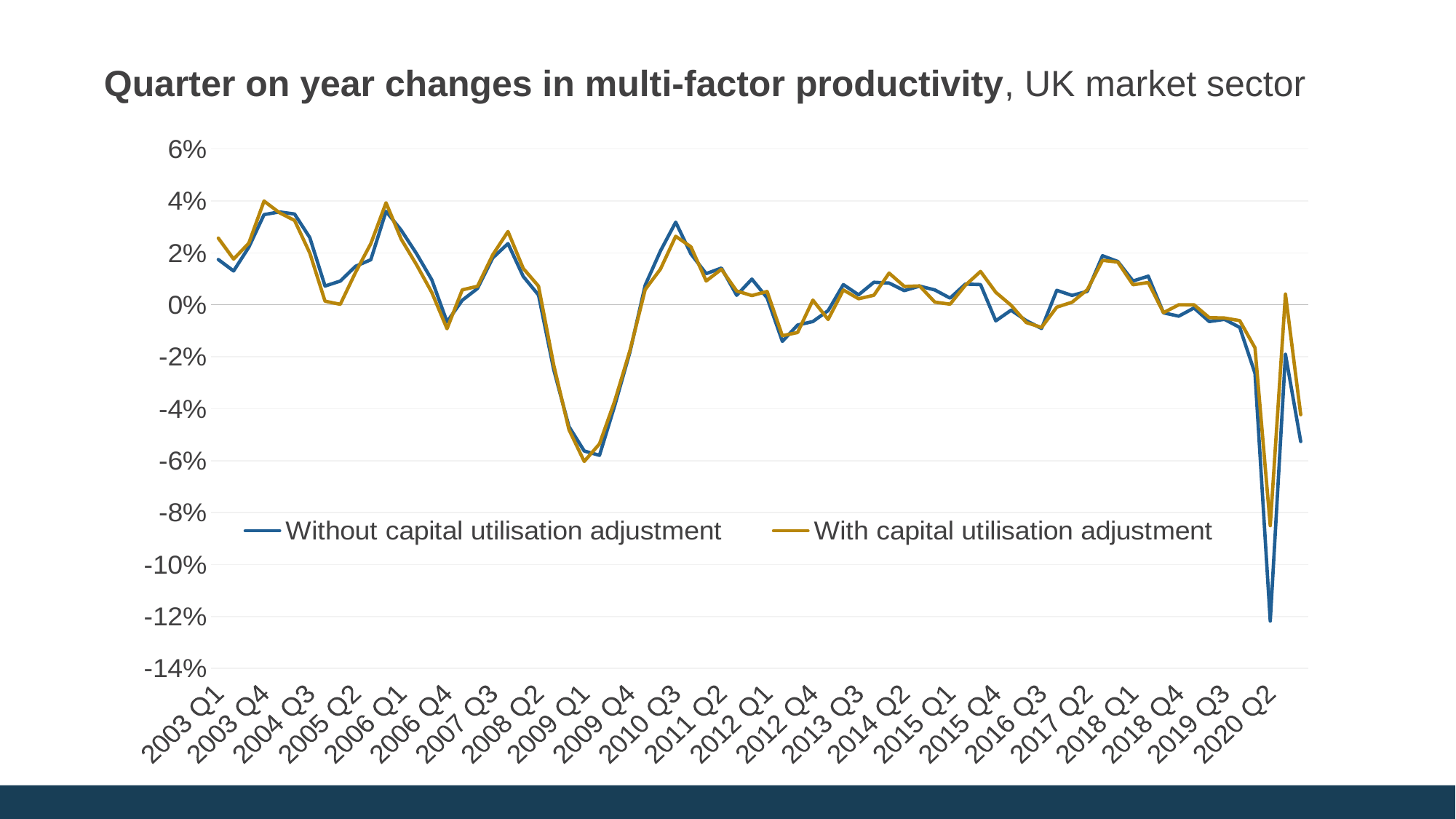
Is the value for 'Without capital utilisation adjustment' at 2020 Q2 greater or less than -10%? less Which series reaches the lowest value on the chart? Without capital utilisation adjustment What is the title of the chart? Quarter on year changes in multi-factor productivity, UK market sector How many series does the legend list? 2 Does the 'With capital utilisation adjustment' series rise or fall between 2003 Q1 and 2003 Q4? rise What kind of chart is shown on the slide? line chart At 2020 Q2, which series has the larger value? With capital utilisation adjustment What is the lowest value shown on the vertical axis? -14% Is the value for 'With capital utilisation adjustment' at 2020 Q2 greater or less than -10%? greater Is the value for 'Without capital utilisation adjustment' at 2010 Q3 greater or less than 2%? greater Which series is drawn in blue? Without capital utilisation adjustment